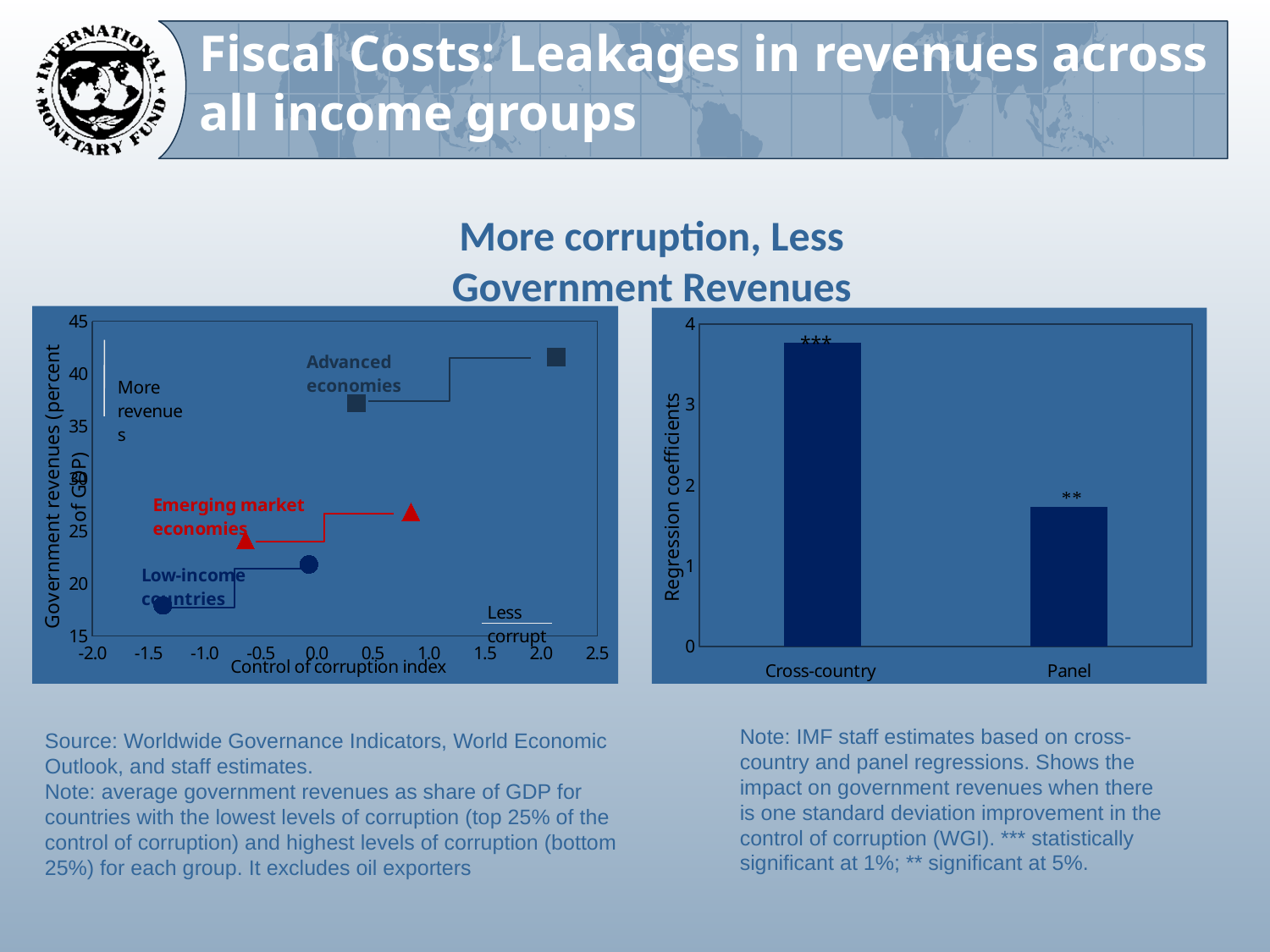
In the right-hand chart, which category has the larger regression coefficient, Cross-country or Panel? Cross-country In the left-hand scatter chart, is the higher of the two Advanced economies points greater or less than 40 percent of GDP? greater What is the x-axis label of the left-hand scatter chart? Control of corruption index What kind of chart is the left-hand chart plotting government revenues against the control of corruption index? scatter chart What is the y-axis label of the right-hand chart? Regression coefficients What kind of chart is the right-hand chart with Cross-country and Panel? bar chart In the left-hand scatter chart, which country group has the lowest government revenues as a percent of GDP? Low-income countries How many categories are shown on the x axis of the right-hand chart? 2 How many country groups are labelled in the left-hand scatter chart? 3 In the right-hand chart, is the regression coefficient for Panel greater or less than 2? less In the right-hand chart, is the regression coefficient for Cross-country greater or less than 3? greater In the left-hand scatter chart, which country group has the highest government revenues as a percent of GDP? Advanced economies